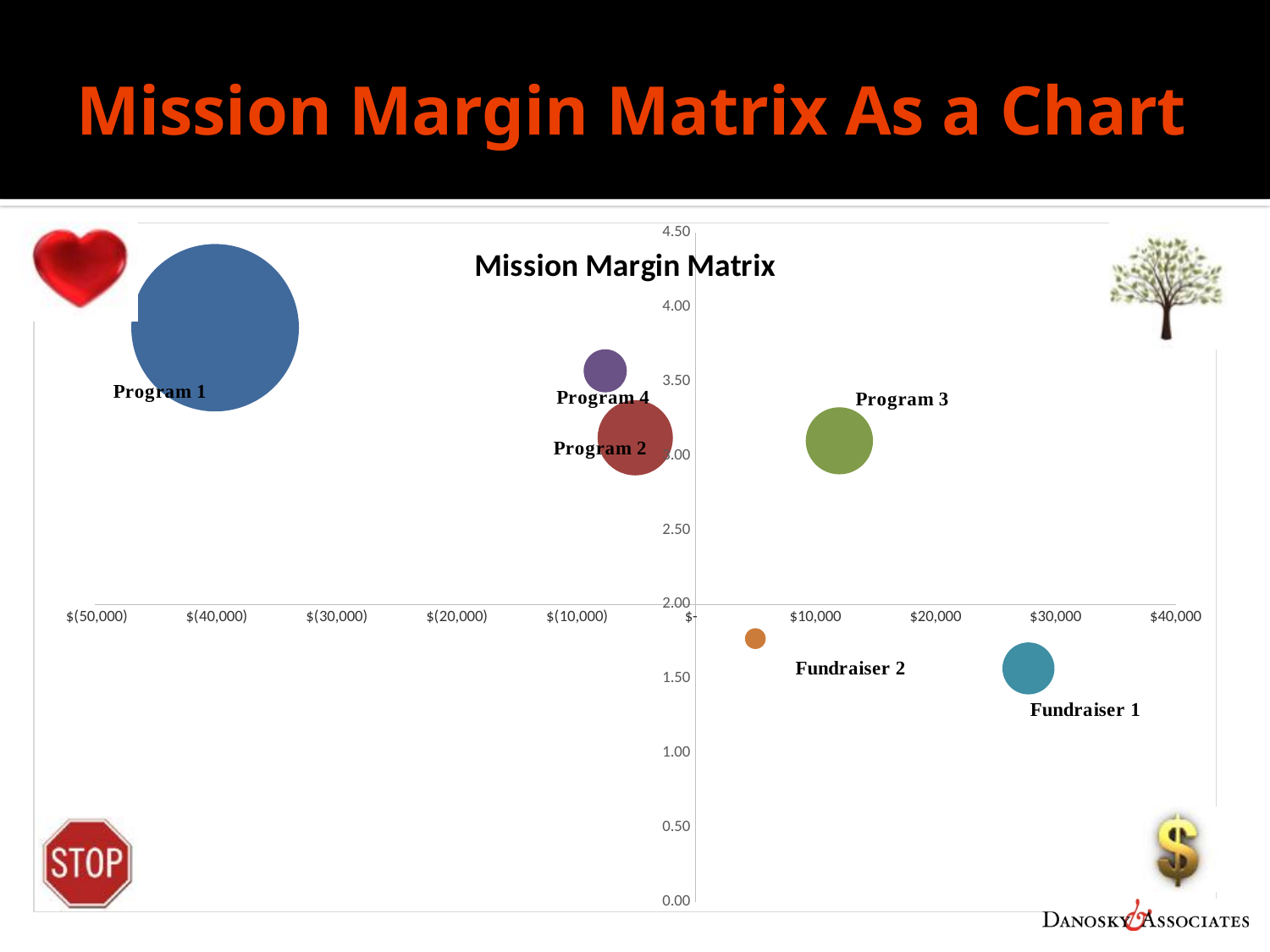
Is the vertical-axis value for Fundraiser 2 greater or less than 2.00? less Which bubble is positioned highest on the vertical axis? Program 1 Which bubble is the largest in size on the chart? Program 1 Which bubble is furthest to the left on the horizontal axis? Program 1 Which bubble is positioned lowest on the vertical axis? Fundraiser 1 Is the vertical-axis value for Program 1 greater or less than 3.50? greater Which is positioned higher on the vertical axis, Program 4 or Program 2? Program 4 What is the title of the chart? Mission Margin Matrix Which bubble is furthest to the right on the horizontal axis? Fundraiser 1 What kind of chart is shown on the slide? bubble chart Is the horizontal-axis value for Program 3 greater or less than $10,000? greater How many labelled bubbles are plotted on the chart? 6